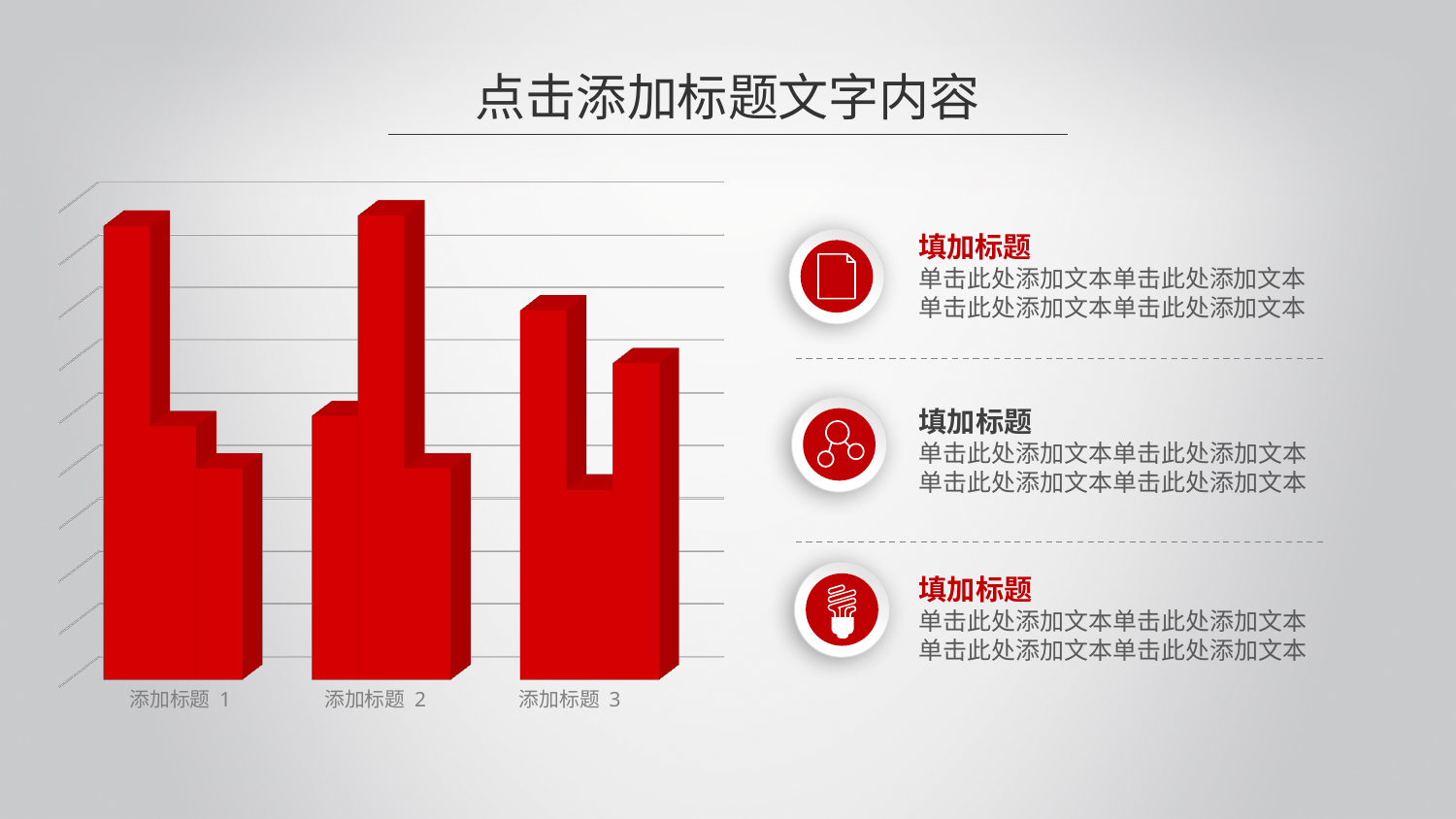
What is the label of the last category on the x axis? 添加标题 3 Which category has the tallest first bar? 添加标题 1 In the category 添加标题 2, which of the three bars is the tallest? the middle bar How many categories are shown on the x axis of the bar chart? 3 What is the label of the first category on the x axis? 添加标题 1 How many bars are drawn for each category in the bar chart? 3 What colour are the bars in the chart? red Which category has the shortest middle bar? 添加标题 3 How many bars are there in total in the bar chart? 9 In the category 添加标题 3, which is taller: the first bar or the middle bar? the first bar In the category 添加标题 1, which is taller: the first bar or the third bar? the first bar What kind of chart is shown on the left of the slide? bar chart